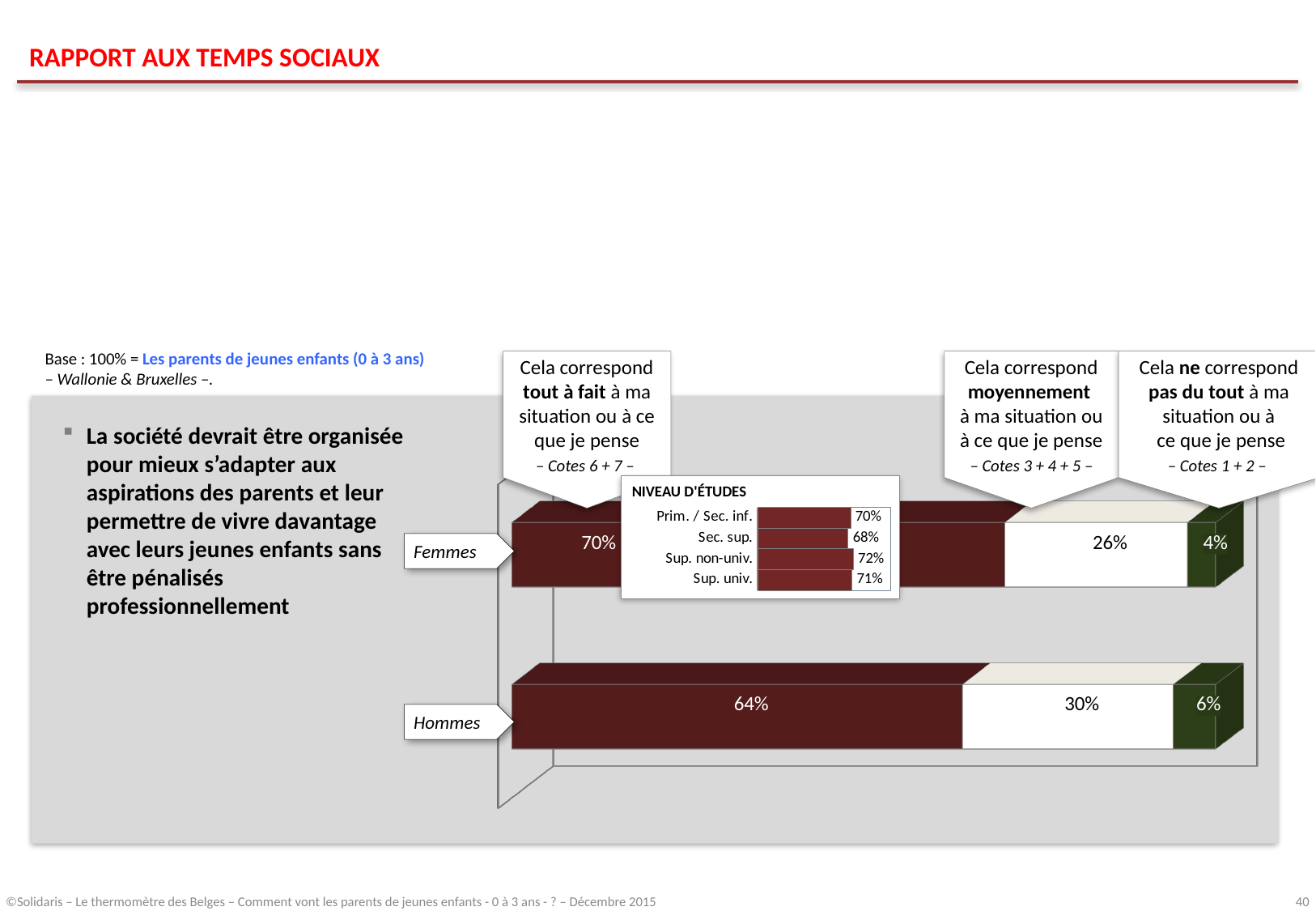
How many education levels are shown in the inset 'NIVEAU D'ÉTUDES' chart? 4 In the main stacked bar chart, what percentage of Hommes say the statement 'ne correspond pas du tout' to their situation? 6% In the inset 'NIVEAU D'ÉTUDES' chart, what is the value for Sec. sup.? 68% In the main stacked bar chart, what percentage of Hommes say the statement corresponds 'moyennement' to their situation? 30% In the main stacked bar chart, what percentage of Femmes say the statement corresponds 'tout à fait' to their situation? 70% In the main stacked bar chart, what is the total of the three segments for the Femmes bar? 100% In the inset 'NIVEAU D'ÉTUDES' chart, which education level has the lowest value? Sec. sup. In the main stacked bar chart, which group has the larger 'pas du tout' share, Femmes or Hommes? Hommes How many categories (groups) are shown in the main stacked bar chart? 2 In the main stacked bar chart, what is the difference between the 'tout à fait' percentages for Femmes and Hommes? 6 points In the inset 'NIVEAU D'ÉTUDES' chart, which education level has the highest value? Sup. non-univ. What type of chart is the main chart showing Femmes and Hommes? Stacked bar chart